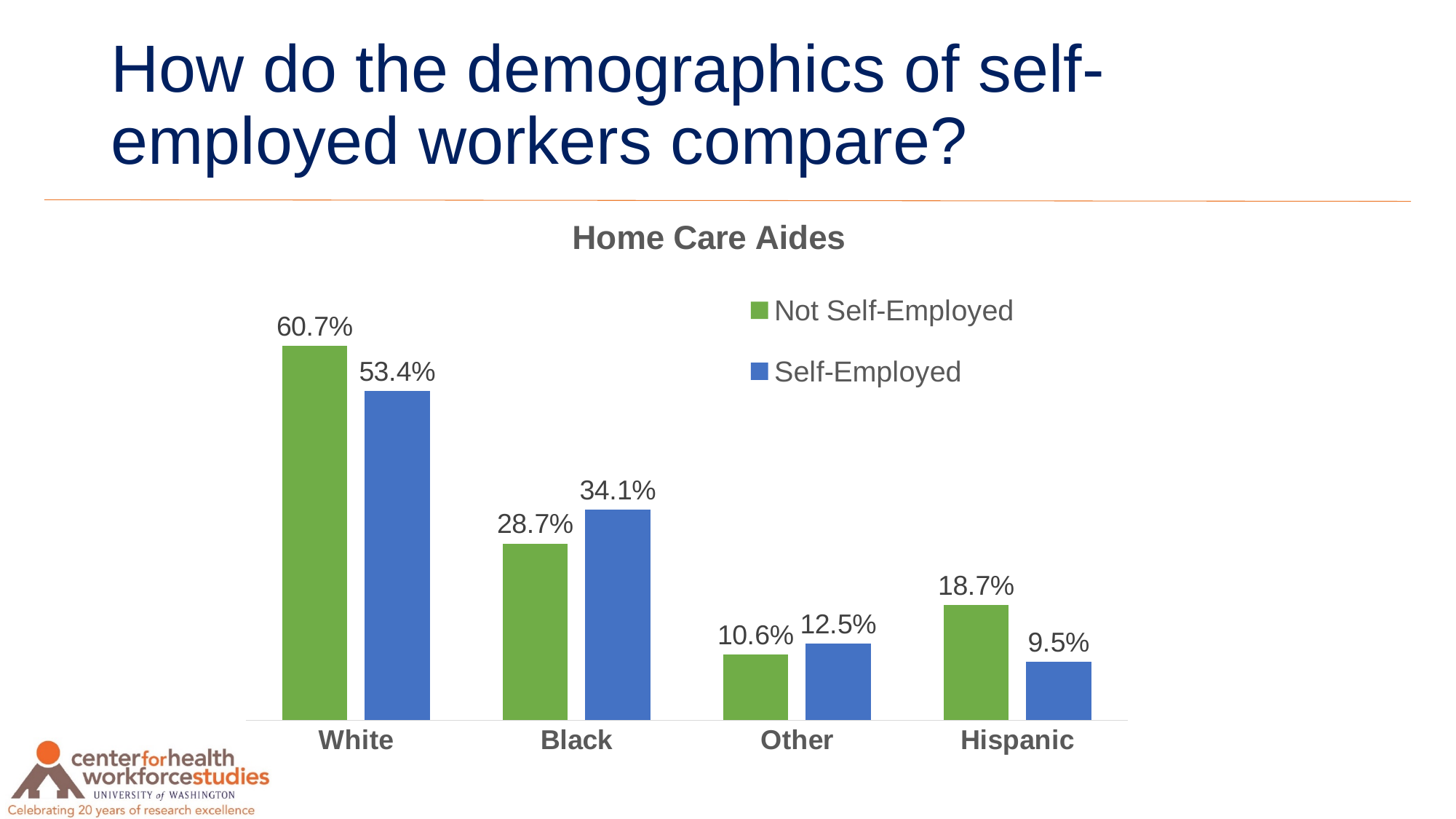
What is the Not Self-Employed value for Other? 10.6% How many series does the legend list? 2 For Hispanic, which is larger: the Not Self-Employed value or the Self-Employed value? Not Self-Employed What is the difference between the Not Self-Employed and Self-Employed values for White? 7.3% What is the Self-Employed value for Hispanic? 9.5% What is the difference between the Self-Employed and Not Self-Employed values for Black? 5.4% What is the Not Self-Employed value for White? 60.7% Which category has the highest Self-Employed value? White What type of chart is shown? Bar chart Which category has the lowest Not Self-Employed value? Other What is the Self-Employed value for Black? 34.1% How many categories are shown on the x axis? 4